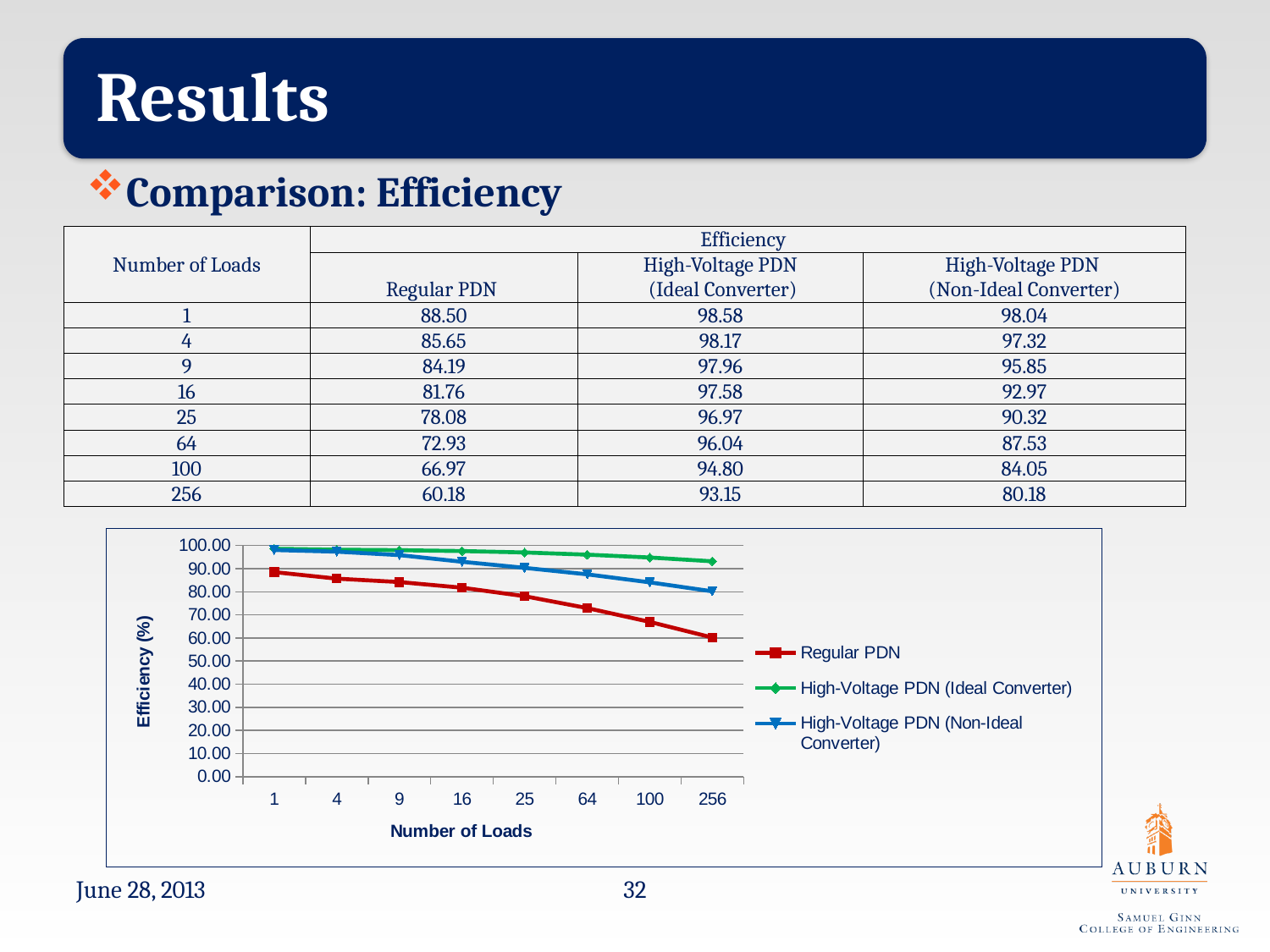
What is the efficiency of the Regular PDN at 256 loads? 60.18 Does the efficiency of the Regular PDN rise or fall as the number of loads increases? fall What kind of chart is shown on the slide? line chart Which series has the highest efficiency at 64 loads? High-Voltage PDN (Ideal Converter) What is the efficiency of the High-Voltage PDN (Non-Ideal Converter) at 100 loads? 84.05 How many series does the chart legend list? 3 What is the difference in efficiency between the High-Voltage PDN (Ideal Converter) and the Regular PDN at 256 loads? 32.97 Which series has the lowest efficiency at 256 loads? Regular PDN What is the label of the y axis of the chart? Efficiency (%) Is the Regular PDN efficiency at 100 loads greater or less than 70.00? less How many points along the x axis (Number of Loads) does each series have? 8 What is the efficiency of the High-Voltage PDN (Ideal Converter) at 1 load? 98.58